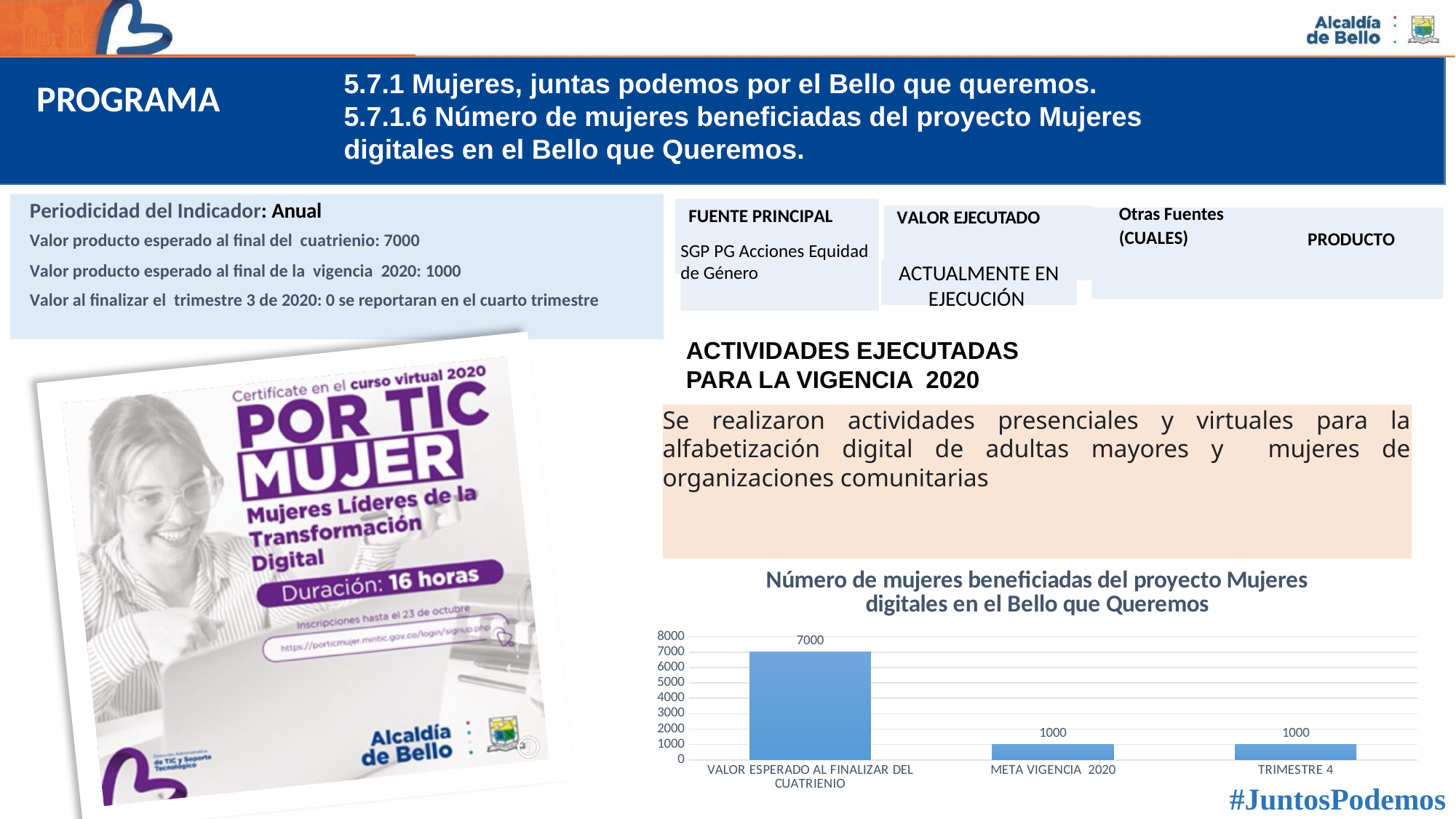
Is the value for VALOR ESPERADO AL FINALIZAR DEL CUATRIENIO greater or less than 5000? greater What is the highest value shown on the chart's vertical axis? 8000 What is the title of the chart? Número de mujeres beneficiadas del proyecto Mujeres digitales en el Bello que Queremos Which is larger, the value for VALOR ESPERADO AL FINALIZAR DEL CUATRIENIO or the value for TRIMESTRE 4? VALOR ESPERADO AL FINALIZAR DEL CUATRIENIO Is the value for META VIGENCIA 2020 greater or less than 3000? less What is the value for TRIMESTRE 4? 1000 Which category has the highest value? VALOR ESPERADO AL FINALIZAR DEL CUATRIENIO What is the value for META VIGENCIA 2020? 1000 What is the value for VALOR ESPERADO AL FINALIZAR DEL CUATRIENIO? 7000 How many categories are shown on the chart? 3 What kind of chart is shown on the slide? bar chart What is the difference between the value for VALOR ESPERADO AL FINALIZAR DEL CUATRIENIO and the value for META VIGENCIA 2020? 6000